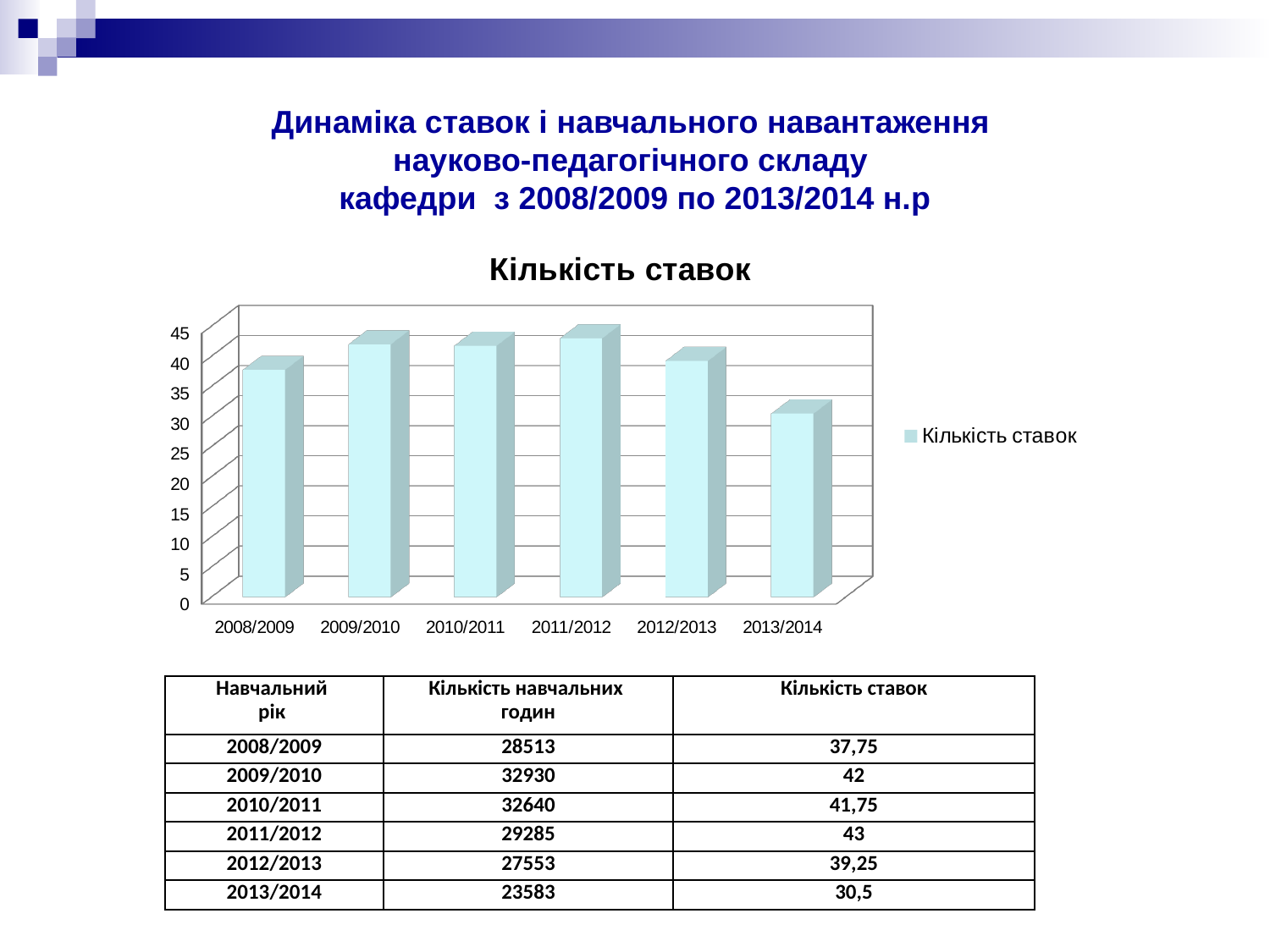
Is the value for 2013/2014 greater or less than 35? less What is the value of Кількість ставок for 2008/2009? 37,75 What is the value of Кількість ставок for 2011/2012? 43 How many series does the chart legend list? 1 How many categories (academic years) are shown on the x axis of the chart? 6 What kind of chart is shown on the slide? bar chart Which is larger, the value for 2009/2010 or the value for 2012/2013? 2009/2010 Which academic year has the highest value for Кількість ставок? 2011/2012 Which academic year has the lowest value for Кількість ставок? 2013/2014 What is the value of Кількість ставок for 2013/2014? 30,5 What is the difference between the value for 2011/2012 and the value for 2013/2014? 12,5 What is the title of the chart? Кількість ставок